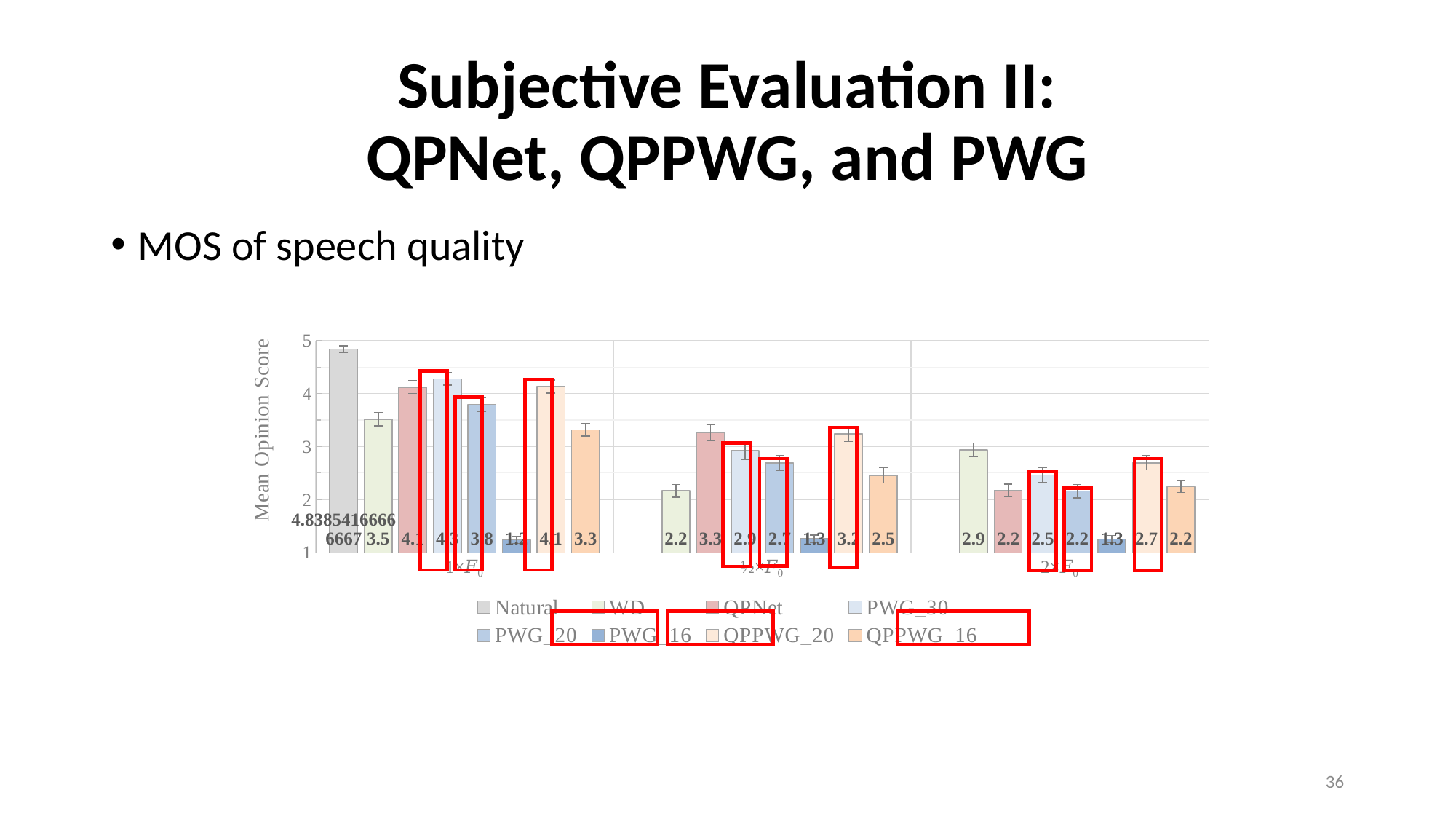
What is the Mean Opinion Score for PWG_16 in the 2×F0 group? 1.3 Is the Mean Opinion Score for Natural in the 1×F0 group greater or less than 4? greater Which series has the highest Mean Opinion Score in the 1×F0 group? Natural What is the Mean Opinion Score for WD in the 1×F0 group? 3.5 What is the title of the vertical axis? Mean Opinion Score In the ½×F0 group, what is the difference between the QPNet score and the WD score? 1.1 How many series does the legend list? 8 What kind of chart is shown on the slide? bar chart What is the Mean Opinion Score for QPPWG_20 in the ½×F0 group? 3.2 In the 2×F0 group, which has the higher Mean Opinion Score, QPPWG_20 or PWG_20? QPPWG_20 What is the Mean Opinion Score for QPPWG_16 in the 1×F0 group? 3.3 Which series has the lowest Mean Opinion Score in the ½×F0 group? PWG_16